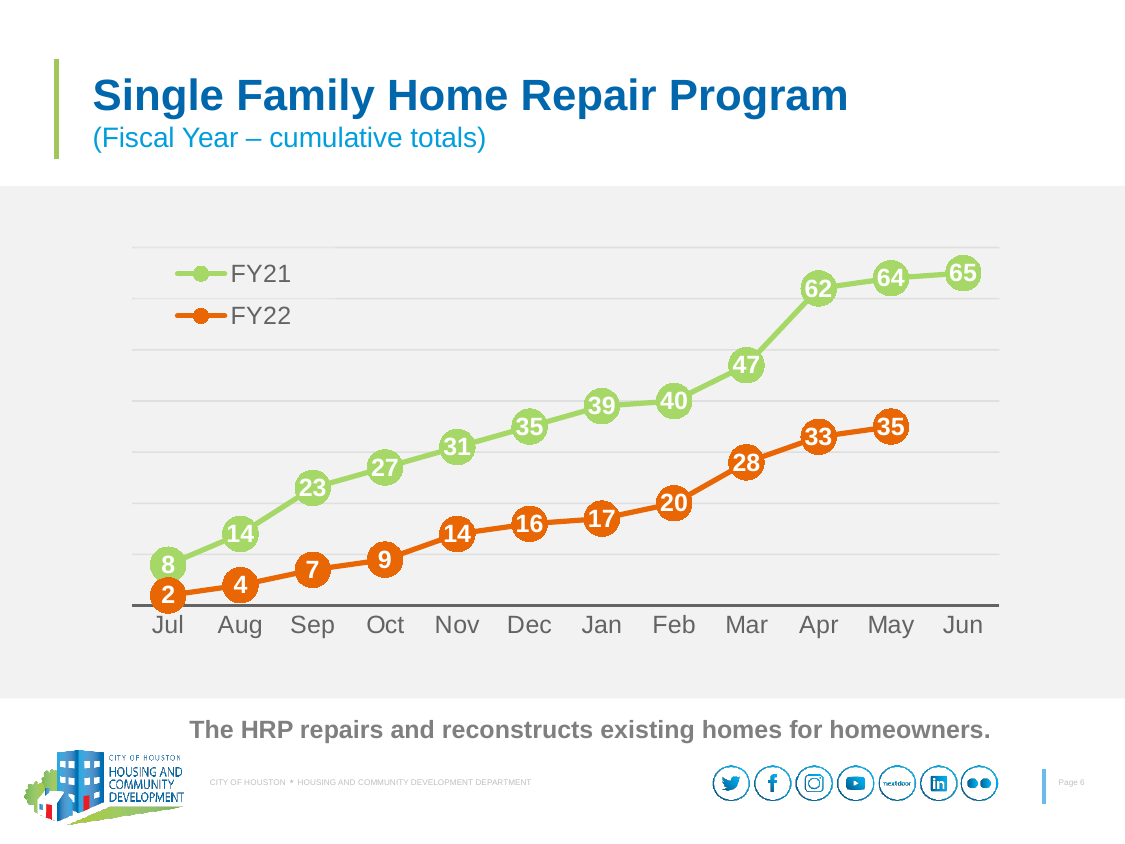
How many months are shown on the x axis? 12 What is the difference between the FY21 and FY22 values in Apr? 29 What kind of chart is shown on the slide? line chart What is the FY21 cumulative total in Jun? 65 How many series does the legend list? 2 What colour is the FY22 line? orange What is the FY22 cumulative total in May? 35 What is the FY21 value in Mar? 47 Do the FY21 values rise or fall from Jul to Jun? rise Which series has the higher value in Dec, FY21 or FY22? FY21 What is the FY22 value in Feb? 20 In which month is the FY22 value lowest? Jul